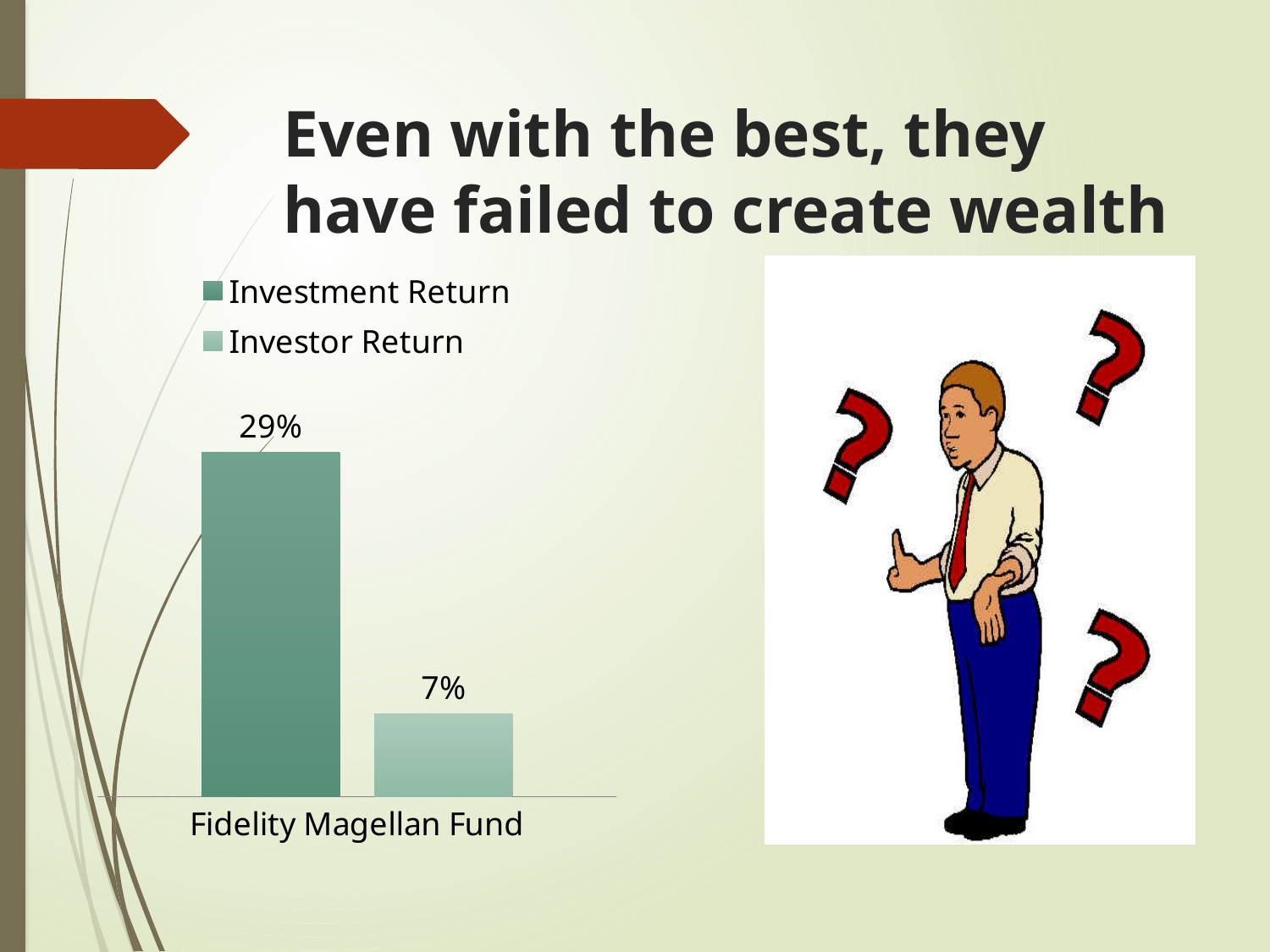
How many categories are shown on the x axis? 1 Which series has the higher value for the Fidelity Magellan Fund? Investment Return What is the Investment Return for the Fidelity Magellan Fund? 29% What is the name of the category shown on the x axis? Fidelity Magellan Fund Is the Investment Return or the Investor Return larger for the Fidelity Magellan Fund? Investment Return How many series does the legend list? 2 What kind of chart is shown on the slide? Bar chart Which series is shown in the lighter green colour? Investor Return Which series has the lower value for the Fidelity Magellan Fund? Investor Return What is the Investor Return for the Fidelity Magellan Fund? 7% What is the difference between the Investment Return and the Investor Return for the Fidelity Magellan Fund? 22%